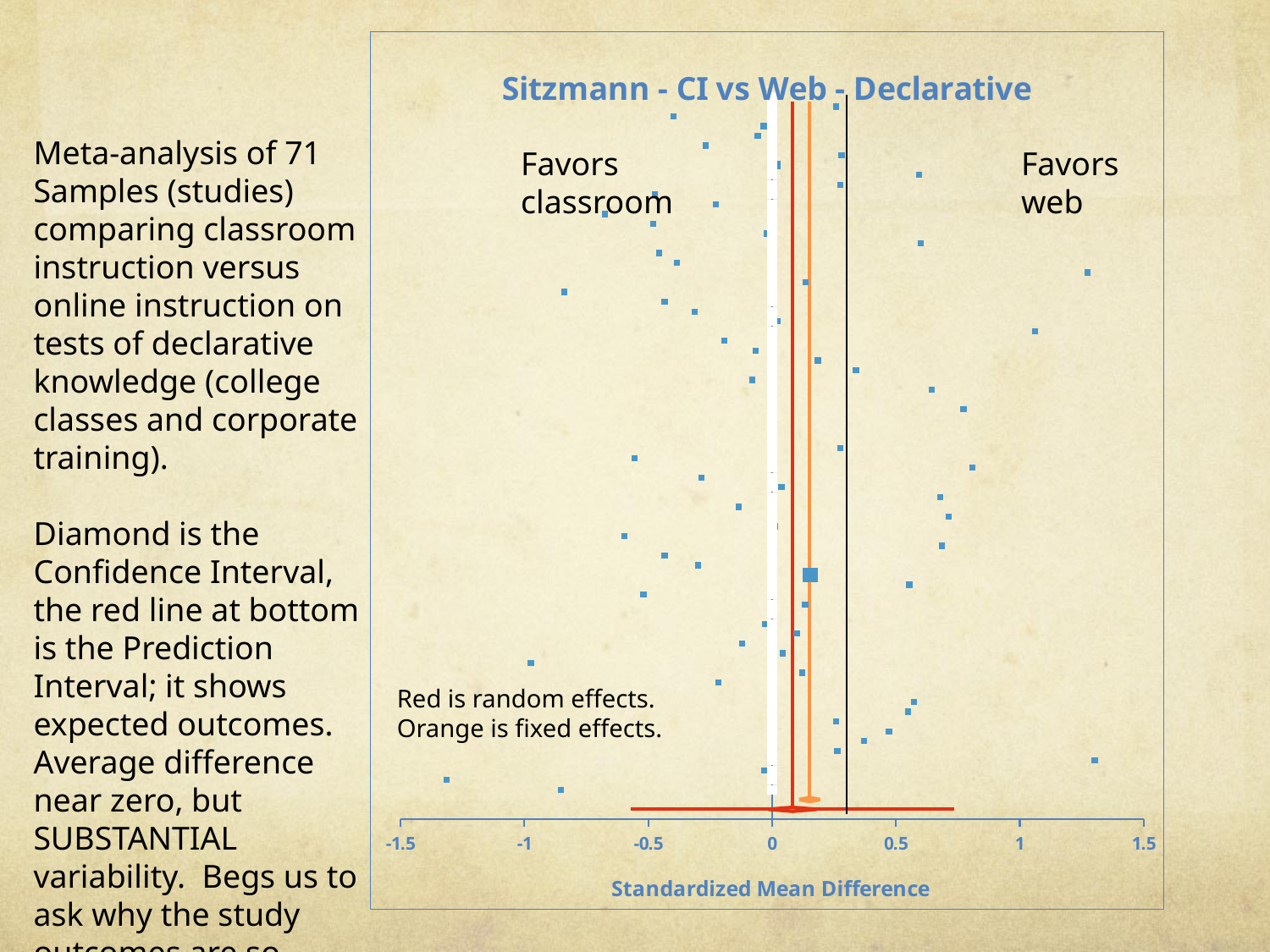
Is the leftmost plotted point greater or less than -1 on the Standardized Mean Difference axis? less According to the slide, how many samples (studies) are plotted in the chart? 71 What is the label of the horizontal axis of the chart? Standardized Mean Difference Is the rightmost plotted point greater or less than 1 on the Standardized Mean Difference axis? greater How many tick labels are shown on the horizontal axis? 7 What is the lowest tick value shown on the horizontal axis? -1.5 What is the highest tick value shown on the horizontal axis? 1.5 What kind of chart is shown on the slide? Scatter chart What is the title of the chart? Sitzmann - CI vs Web - Declarative